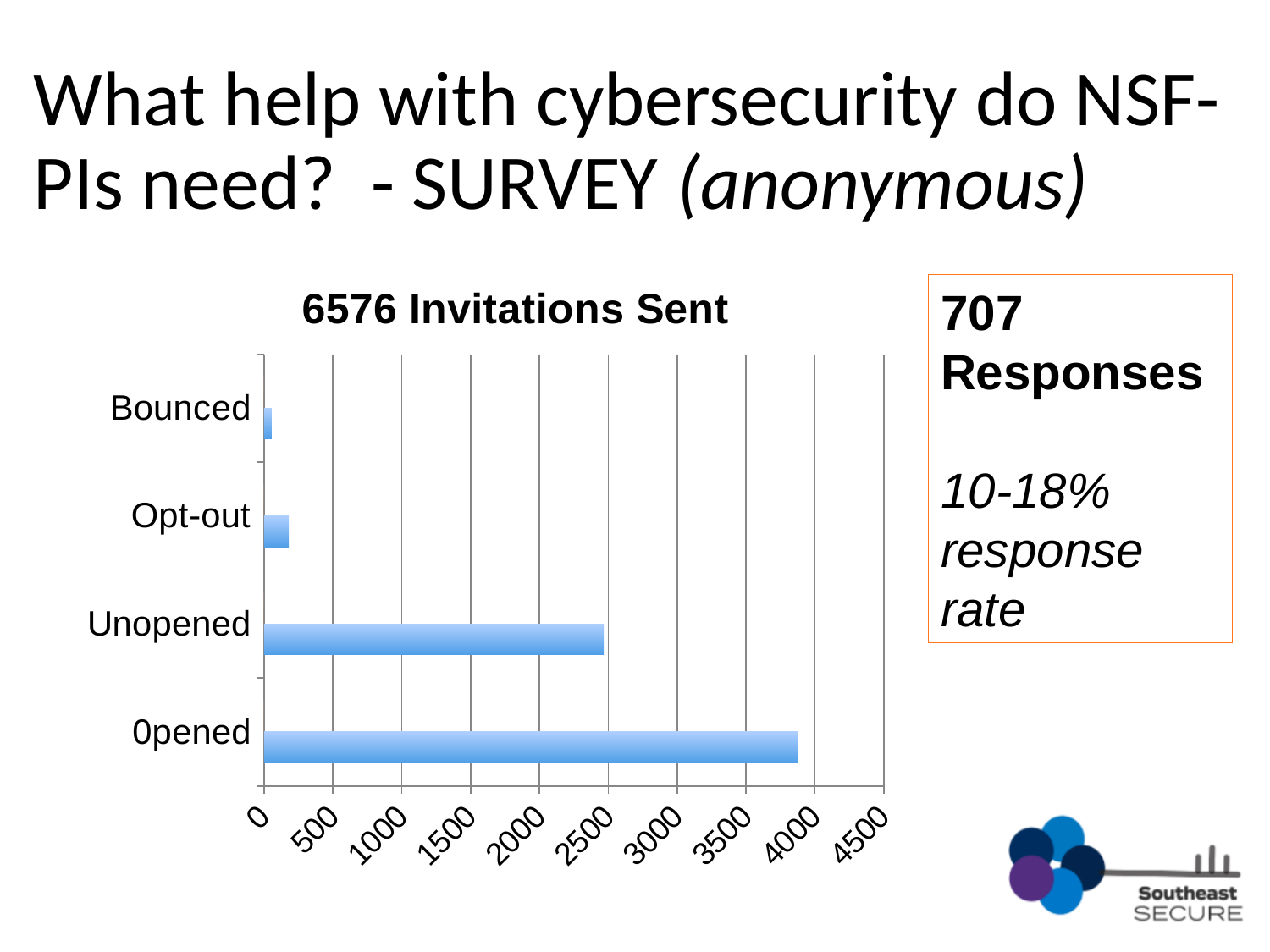
Which is larger, the value for Unopened or the value for Opt-out? Unopened How many categories are plotted in the chart? 4 Is the value for Unopened greater or less than 2000? greater Is the value for Opened greater or less than 3500? greater Which is larger, the value for Opened or the value for Unopened? Opened What is the title of the chart? 6576 Invitations Sent Which category has the lowest value in the chart? Bounced What kind of chart is shown on the slide? bar chart Is the value for Opened greater or less than 4000? less Which category has the highest value in the chart? Opened